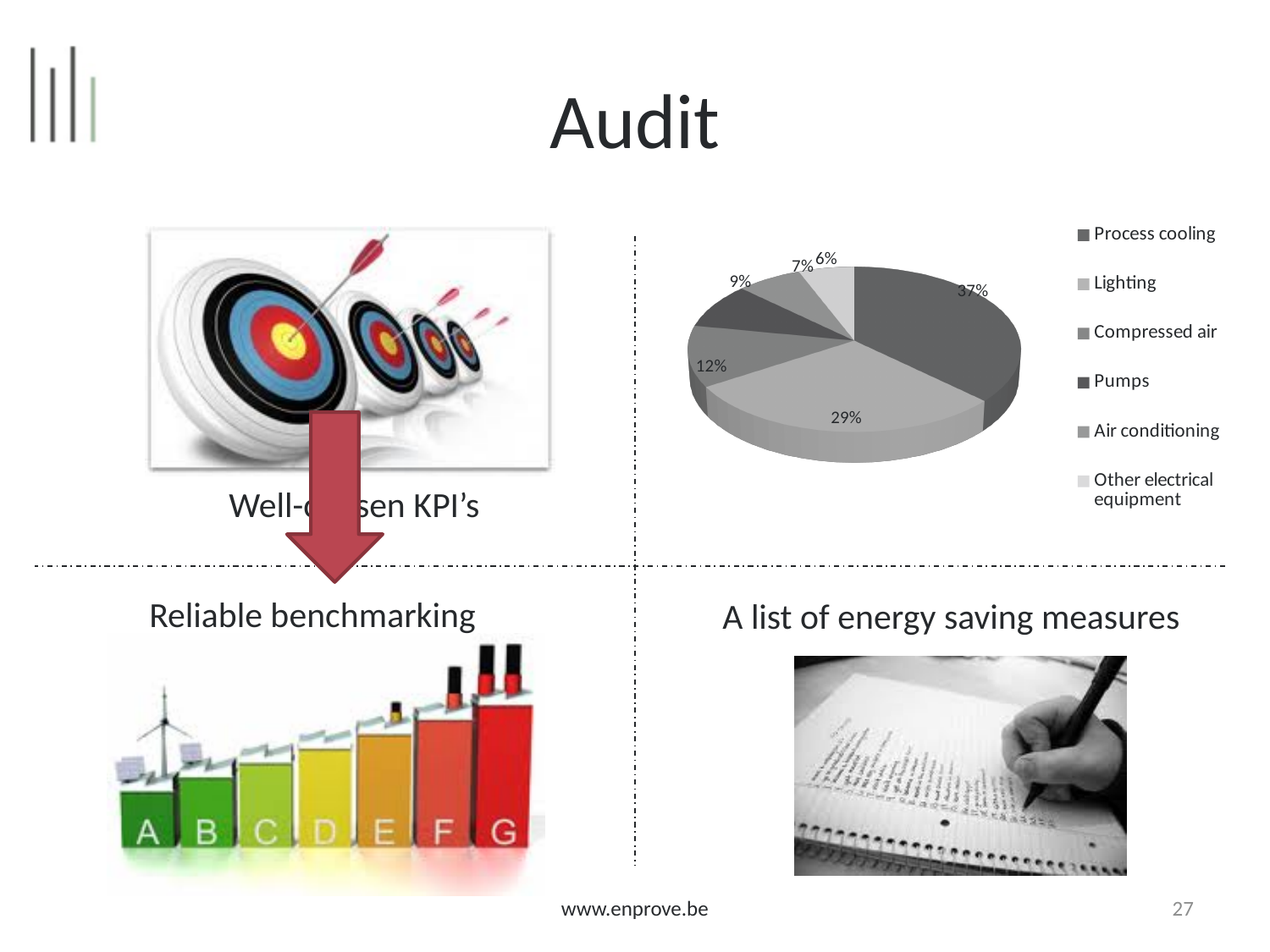
What share of the pie does Pumps take? 9% Which category has the largest slice of the pie? Process cooling How many entries does the pie chart's legend list? 6 What share of the pie does Other electrical equipment take? 6% What share of the pie does Process cooling take? 37% What kind of chart is shown on the slide? pie chart How many slices does the pie chart have? 6 Which category has the smallest slice of the pie? Other electrical equipment What is the difference in percentage points between Process cooling and Lighting? 8 Which is larger, the share for Pumps or the share for Air conditioning? Pumps